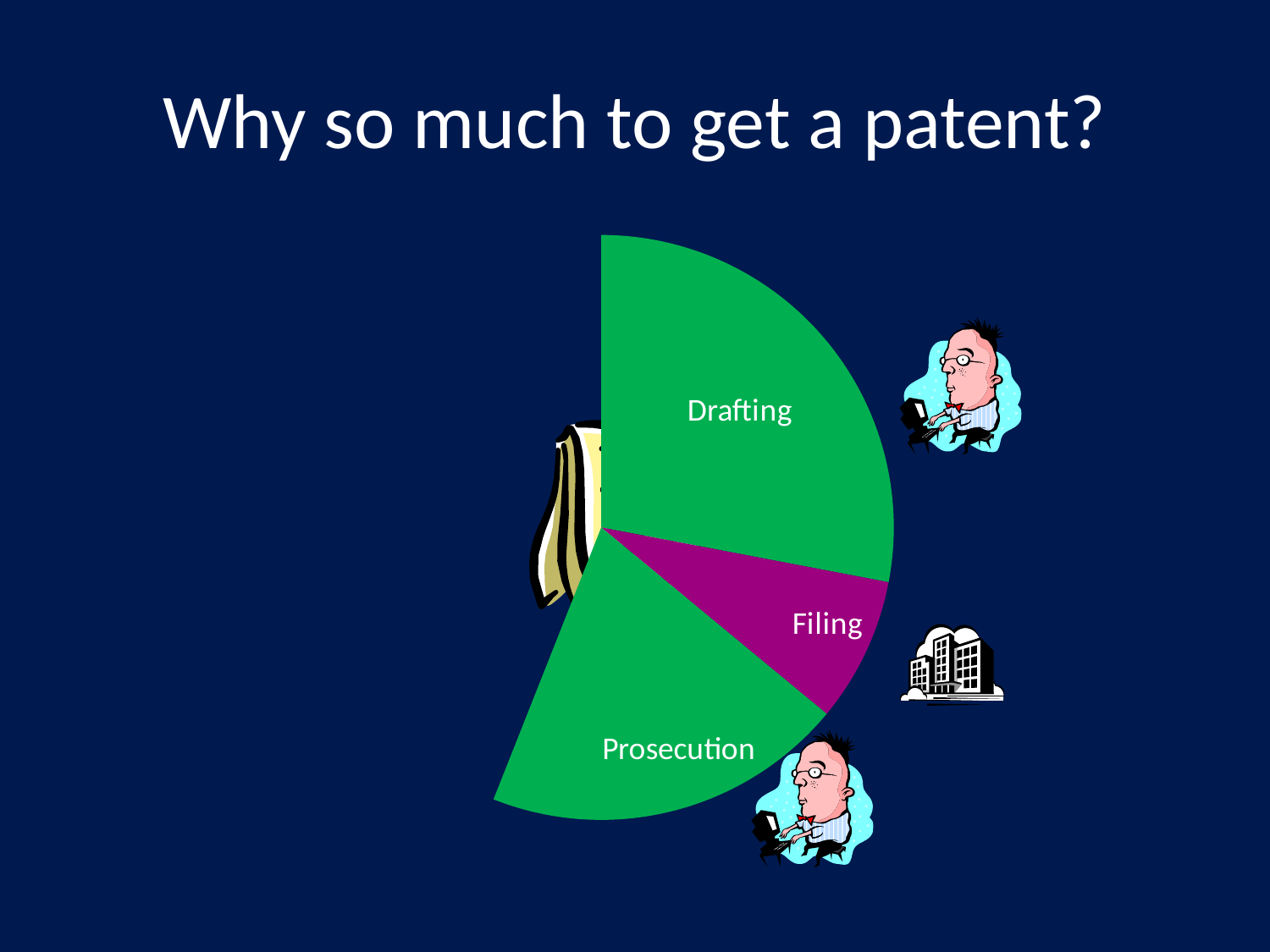
Which slice is larger, Drafting or Filing? Drafting What kind of chart is shown on the slide? pie chart What colour is the Filing slice of the pie chart? purple What is the title of the slide containing the pie chart? Why so much to get a patent? Which slice is larger, Prosecution or Filing? Prosecution Which slice of the pie chart is the smallest? Filing